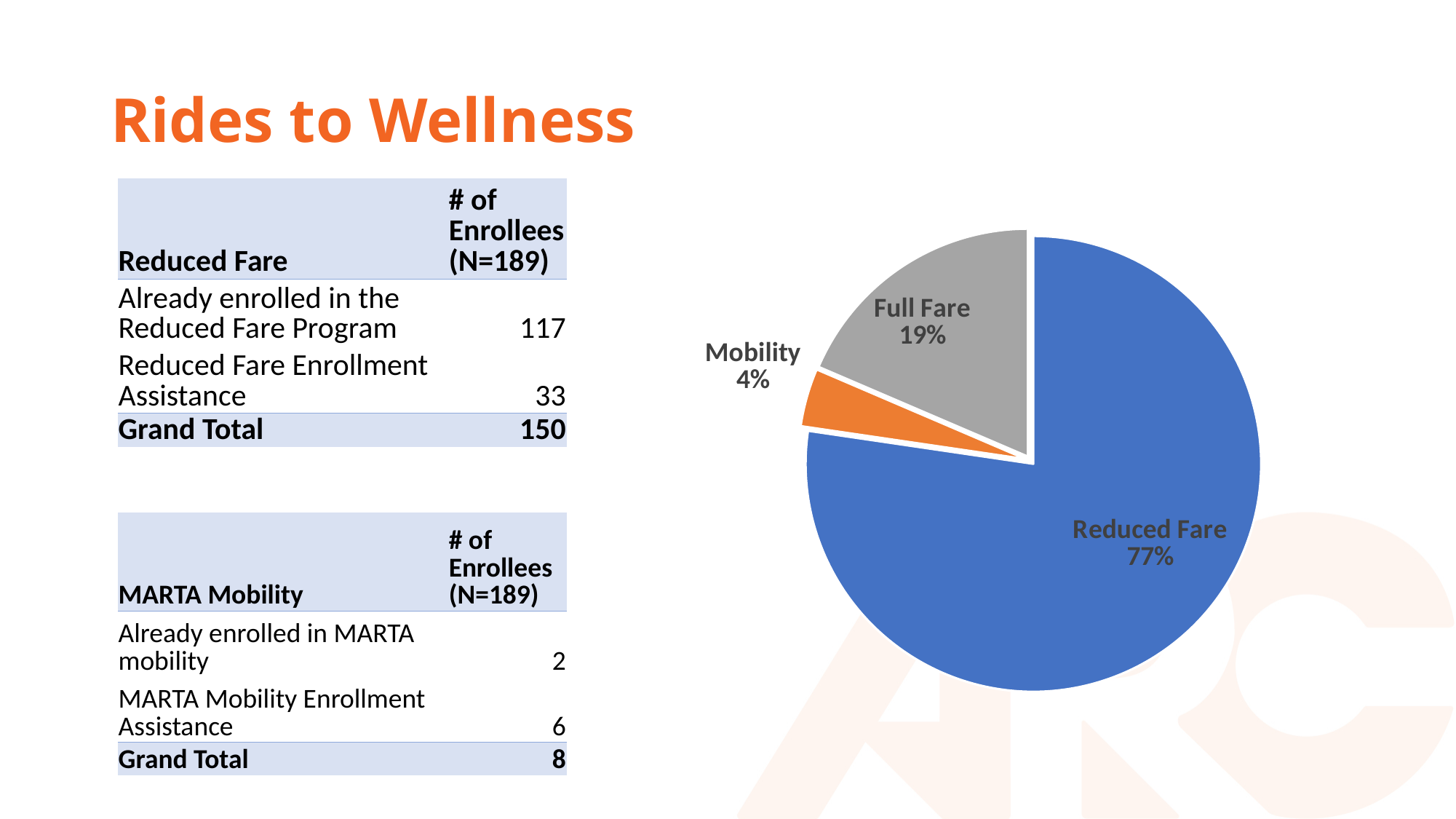
What share of the pie chart is Mobility? 4% In the pie chart, which is larger: Full Fare or Mobility? Full Fare Which slice of the pie chart is the largest? Reduced Fare Which slice of the pie chart is the smallest? Mobility What share of the pie chart is Reduced Fare? 77% What share of the pie chart is Full Fare? 19% What colour is the Reduced Fare slice in the pie chart? blue What colour is the Mobility slice in the pie chart? orange What type of chart is shown on the slide? pie chart In the pie chart, what is the difference in percentage points between Full Fare and Mobility? 15 How many slices does the pie chart have? 3 In the pie chart, what is the difference in percentage points between Reduced Fare and Full Fare? 58